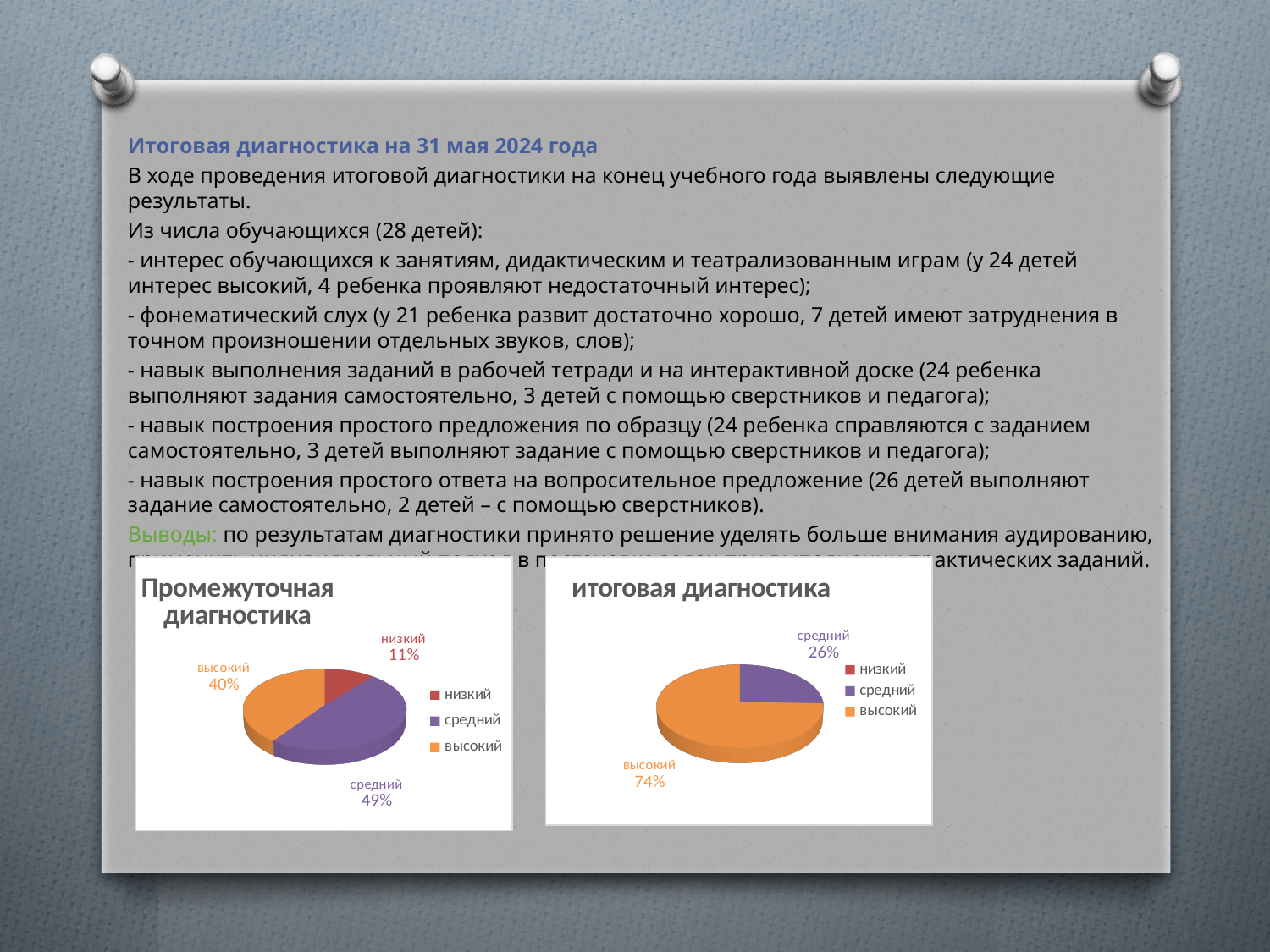
In the 'Промежуточная диагностика' chart, what share does 'средний' have? 49% In the 'итоговая диагностика' chart, which category has the largest share? высокий In the 'итоговая диагностика' chart, what share does 'высокий' have? 74% In the 'Промежуточная диагностика' chart, what is the difference between the shares of 'средний' and 'высокий'? 9% In the 'Промежуточная диагностика' chart, what share does 'низкий' have? 11% How many entries does the legend of the 'итоговая диагностика' chart list? 3 In the 'итоговая диагностика' chart, what is the difference between the shares of 'высокий' and 'средний'? 48% In the 'Промежуточная диагностика' chart, what share does 'высокий' have? 40% In the 'Промежуточная диагностика' chart, which category has the smallest share? низкий In the 'Промежуточная диагностика' chart, which category has the largest share? средний In the 'итоговая диагностика' chart, what share does 'средний' have? 26% What type of chart is the 'итоговая диагностика' chart? Pie chart